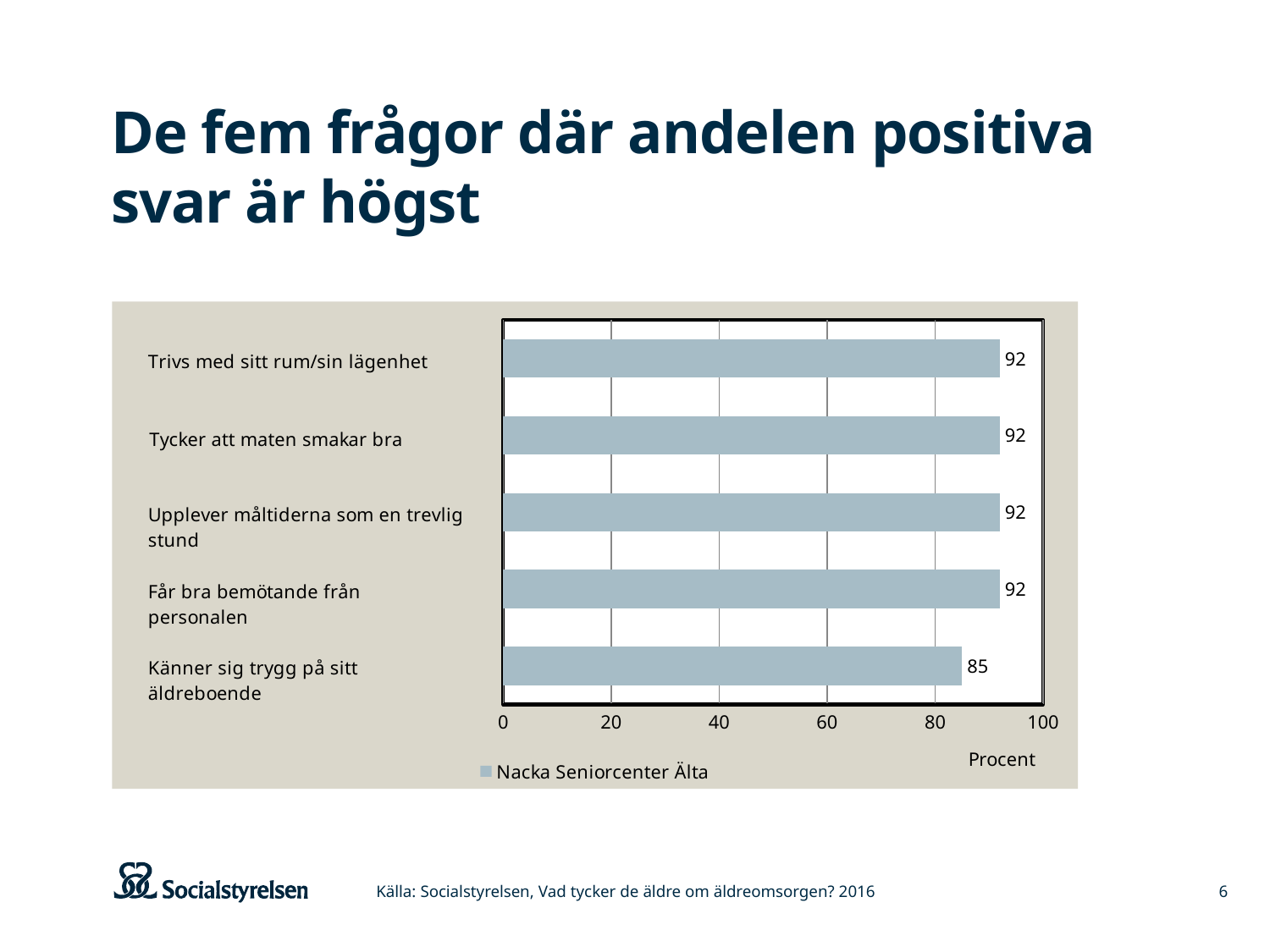
What is the value for "Trivs med sitt rum/sin lägenhet"? 92 What series name is shown in the legend? Nacka Seniorcenter Älta What is the difference between the values for "Får bra bemötande från personalen" and "Känner sig trygg på sitt äldreboende"? 7 How many categories are shown in the chart? 5 Which is larger: the value for "Upplever måltiderna som en trevlig stund" or the value for "Känner sig trygg på sitt äldreboende"? Upplever måltiderna som en trevlig stund What is the value for "Känner sig trygg på sitt äldreboende"? 85 What kind of chart is shown on the slide? bar chart What is the label of the horizontal axis? Procent How many series does the legend list? 1 Is the value for "Känner sig trygg på sitt äldreboende" greater or less than 80? greater What is the value for "Tycker att maten smakar bra"? 92 Which category has the lowest value? Känner sig trygg på sitt äldreboende